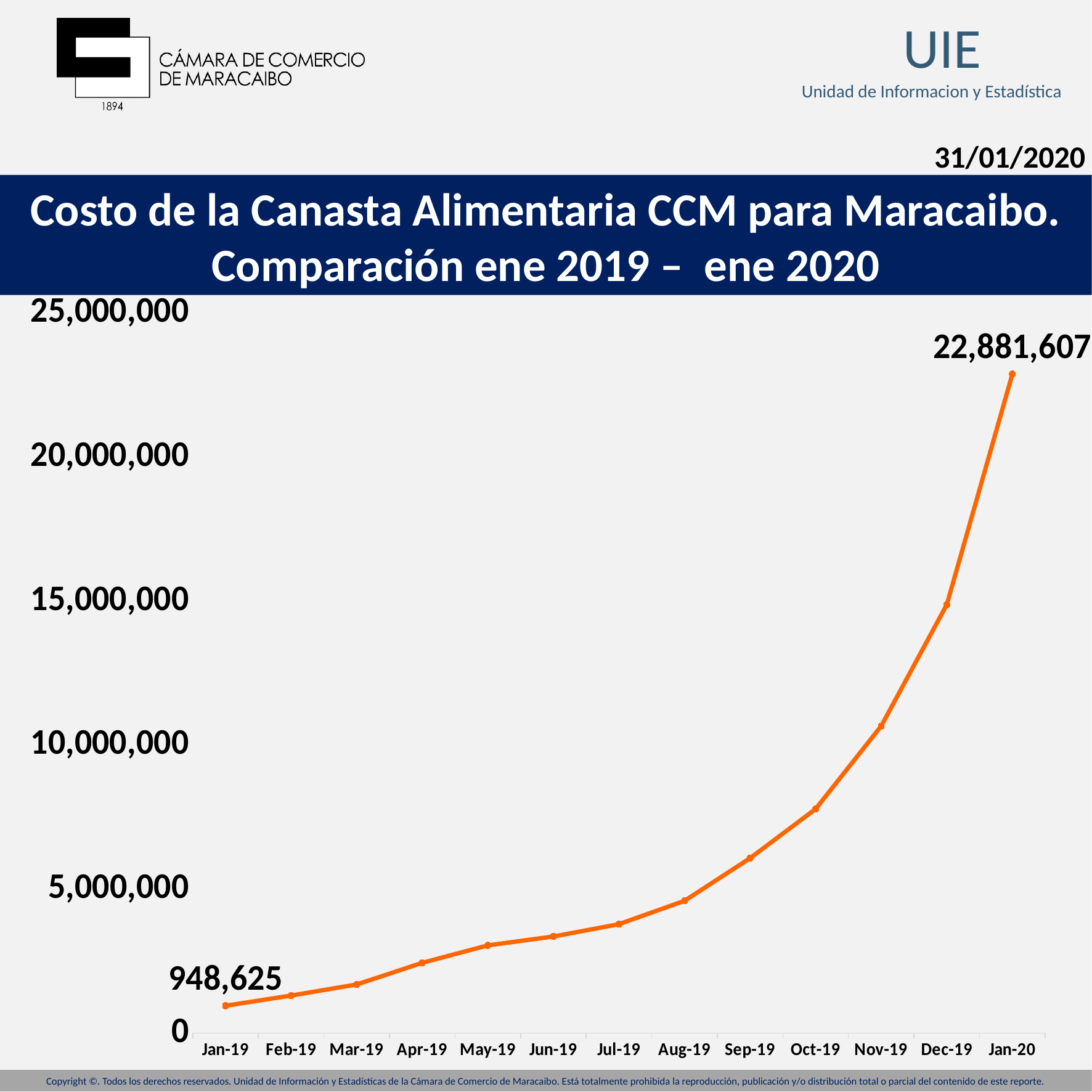
Is the value for Jul-19 greater or less than 5,000,000? less What kind of chart is shown on the slide? line chart How many months are plotted on the x axis? 13 What is the difference between the values for Jan-20 and Jan-19? 21,932,982 Is the value for Nov-19 greater or less than 10,000,000? greater What is the value for Jan-19? 948,625 Which month has the lowest value? Jan-19 Do the values rise or fall from Jan-19 to Jan-20? rise Which is larger, the value for Jan-20 or the value for Jan-19? Jan-20 Which month has the highest value? Jan-20 Is the value for Oct-19 greater or less than 5,000,000? greater What is the value for Jan-20? 22,881,607